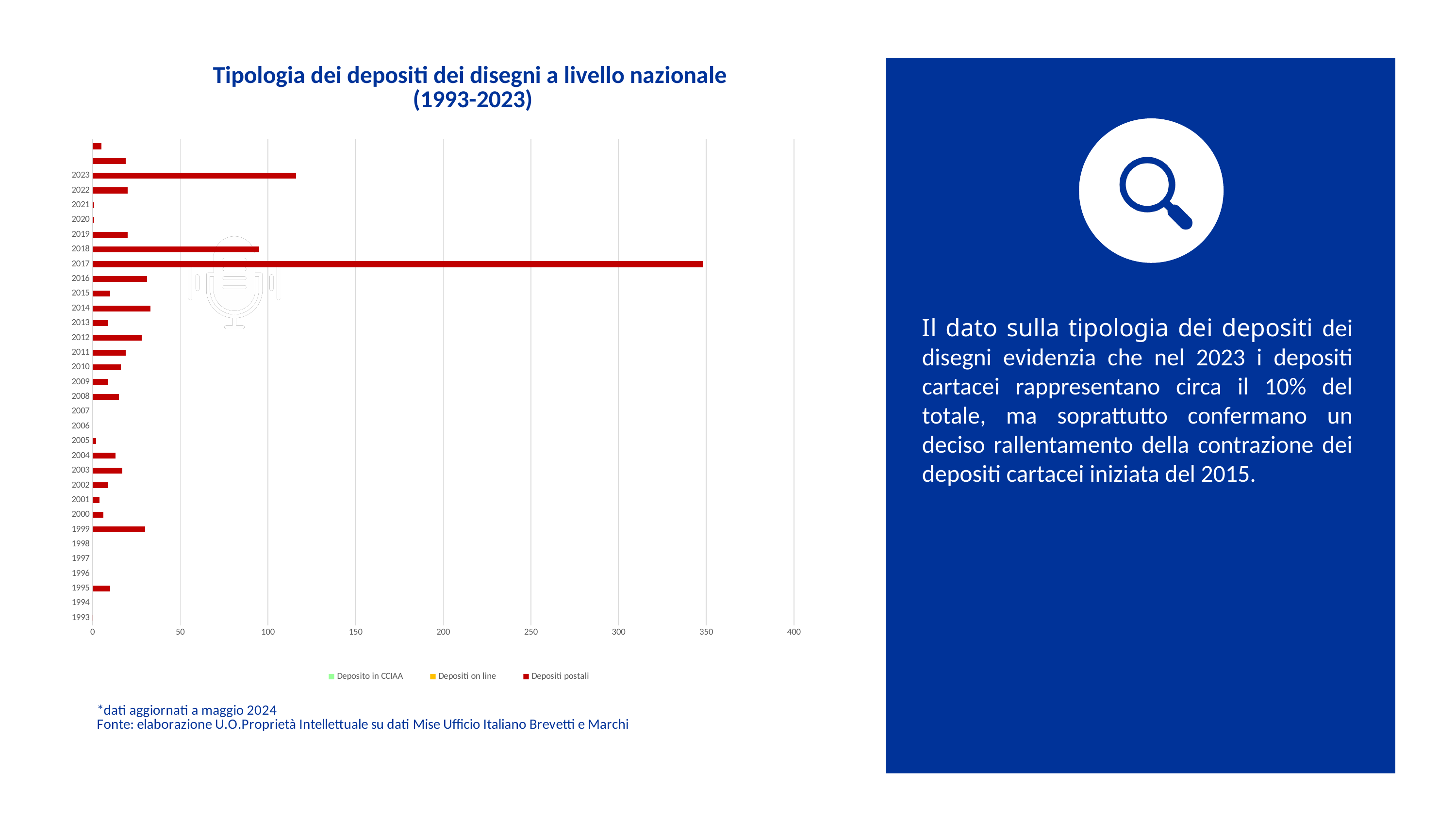
How many series does the legend list? 3 Which year has the highest value for Depositi postali? 2017 What is the title of the chart? Tipologia dei depositi dei disegni a livello nazionale (1993-2023) Which is larger, the Depositi postali value for 2018 or for 2016? 2018 Which is larger, the Depositi postali value for 2017 or for 2018? 2017 What kind of chart is shown on the slide? bar chart Is the value for Depositi postali in 2018 greater or less than 50? greater How many years are labelled on the vertical axis of the chart? 31 Is the value for Depositi postali in 2016 greater or less than 50? less Is the value for Depositi postali in 2017 greater or less than 300? greater Which colour represents the series 'Depositi postali' in the legend? red